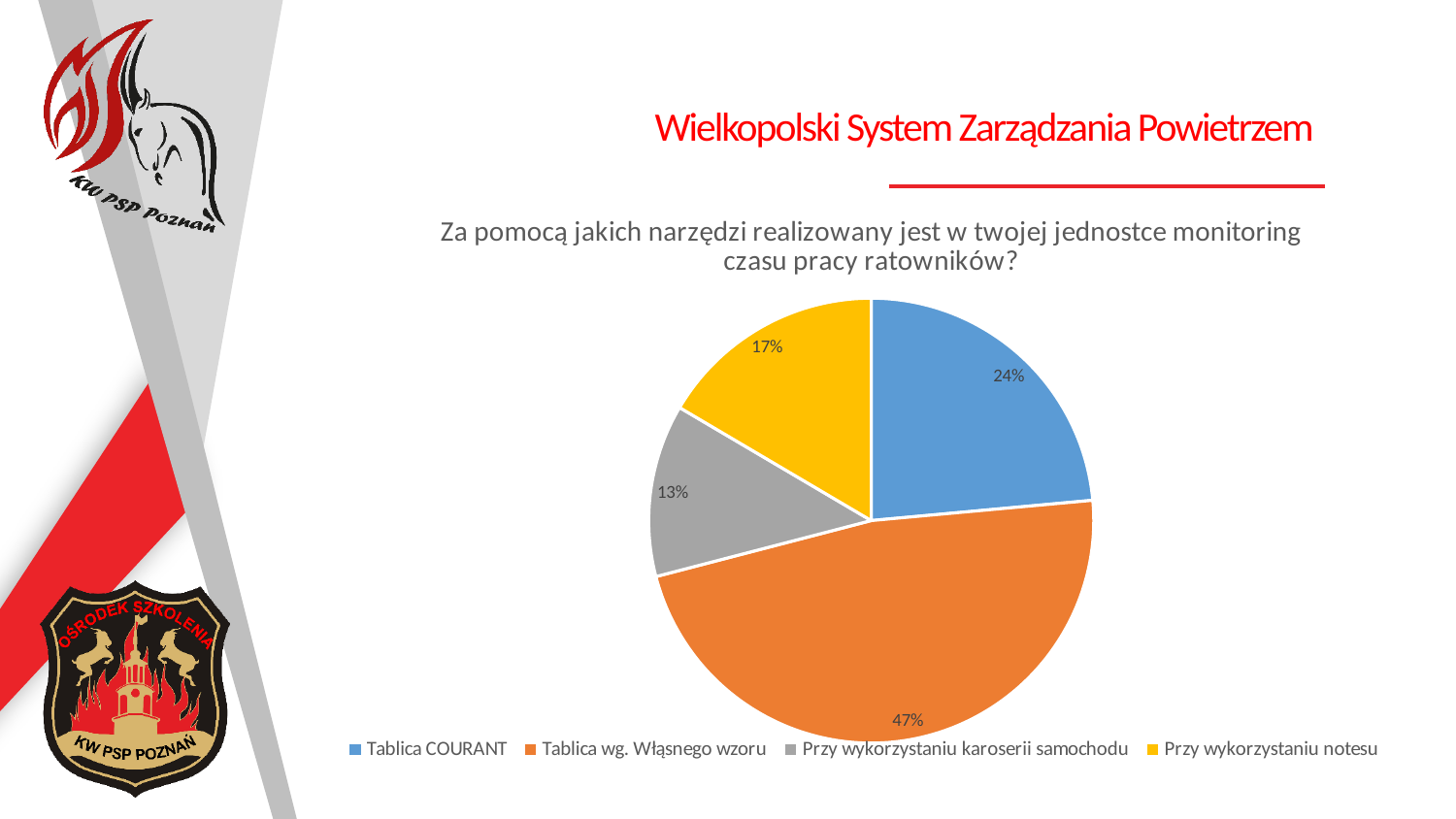
What is the title of the chart? Za pomocą jakich narzędzi realizowany jest w twojej jednostce monitoring czasu pracy ratowników? What kind of chart is shown on the slide? Pie chart What share of the pie does 'Przy wykorzystaniu notesu' represent? 17% What share of the pie does 'Tablica wg. Własnego wzoru' represent? 47% What share of the pie does 'Przy wykorzystaniu karoserii samochodu' represent? 13% Which category has the largest slice of the pie? Tablica wg. Własnego wzoru Which category has the smallest slice of the pie? Przy wykorzystaniu karoserii samochodu How many categories are shown in the pie chart? 4 What colour is the slice for 'Tablica COURANT'? Blue What is the difference in percentage points between 'Tablica wg. Własnego wzoru' and 'Tablica COURANT'? 23 Which is larger: the share for 'Przy wykorzystaniu notesu' or for 'Przy wykorzystaniu karoserii samochodu'? Przy wykorzystaniu notesu